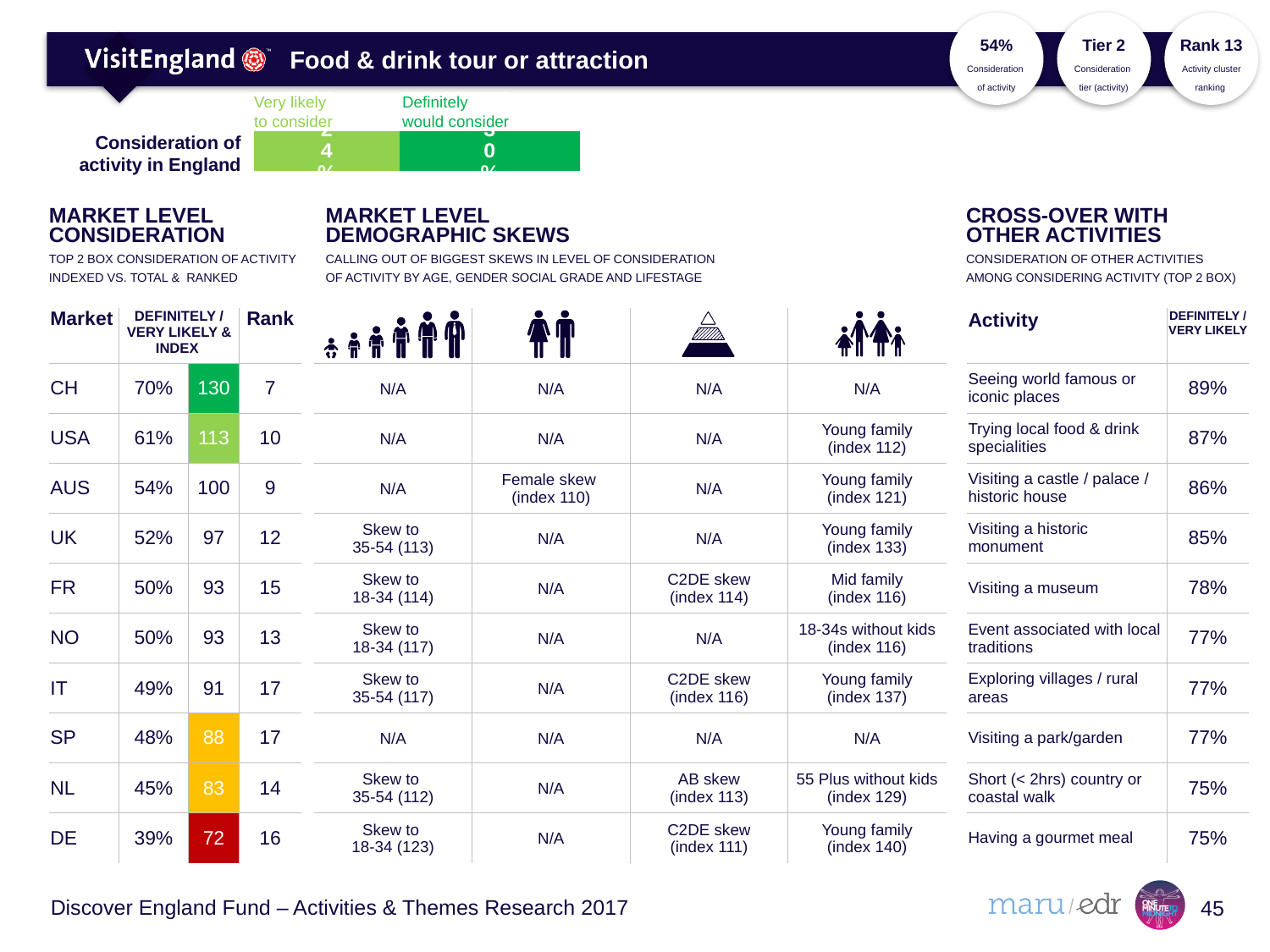
In the 'Consideration of activity in England' chart, which segment is larger: 'Very likely to consider' or 'Definitely would consider'? Definitely would consider Which series in the 'Consideration of activity in England' chart is shown in the lighter green colour? Very likely to consider What are the two series shown in the 'Consideration of activity in England' chart? Very likely to consider; Definitely would consider What kind of chart is the 'Consideration of activity in England' chart? bar chart How many categories (bars) are plotted in the 'Consideration of activity in England' chart? 1 How many series does the legend of the 'Consideration of activity in England' chart list? 2